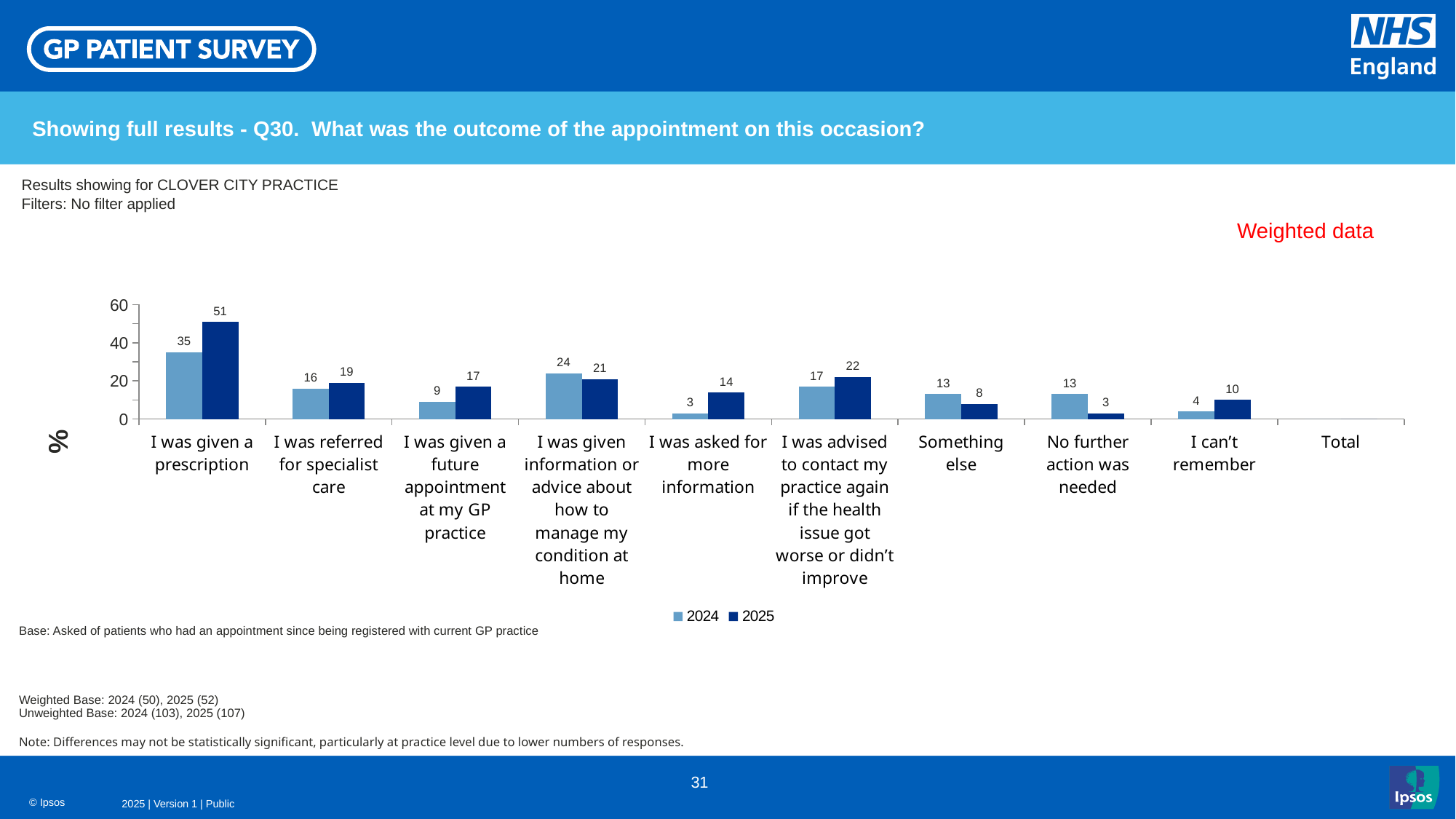
Which is larger for "Something else": the 2024 value or the 2025 value? 2024 Is the 2025 value for "I was given a prescription" greater or less than 40? greater What is the 2025 value for "I was given a prescription"? 51 What is the difference between the 2025 and 2024 values for "I was given a prescription"? 16 How many series does the legend list? 2 What kind of chart is shown on the slide? bar chart What is the difference between the 2024 and 2025 values for "No further action was needed"? 10 What is the 2025 value for "No further action was needed"? 3 Which category has the lowest 2024 value? I was asked for more information Which category has the highest 2025 value? I was given a prescription What is the 2024 value for "I was given information or advice about how to manage my condition at home"? 24 What are the two series listed in the legend? 2024 and 2025